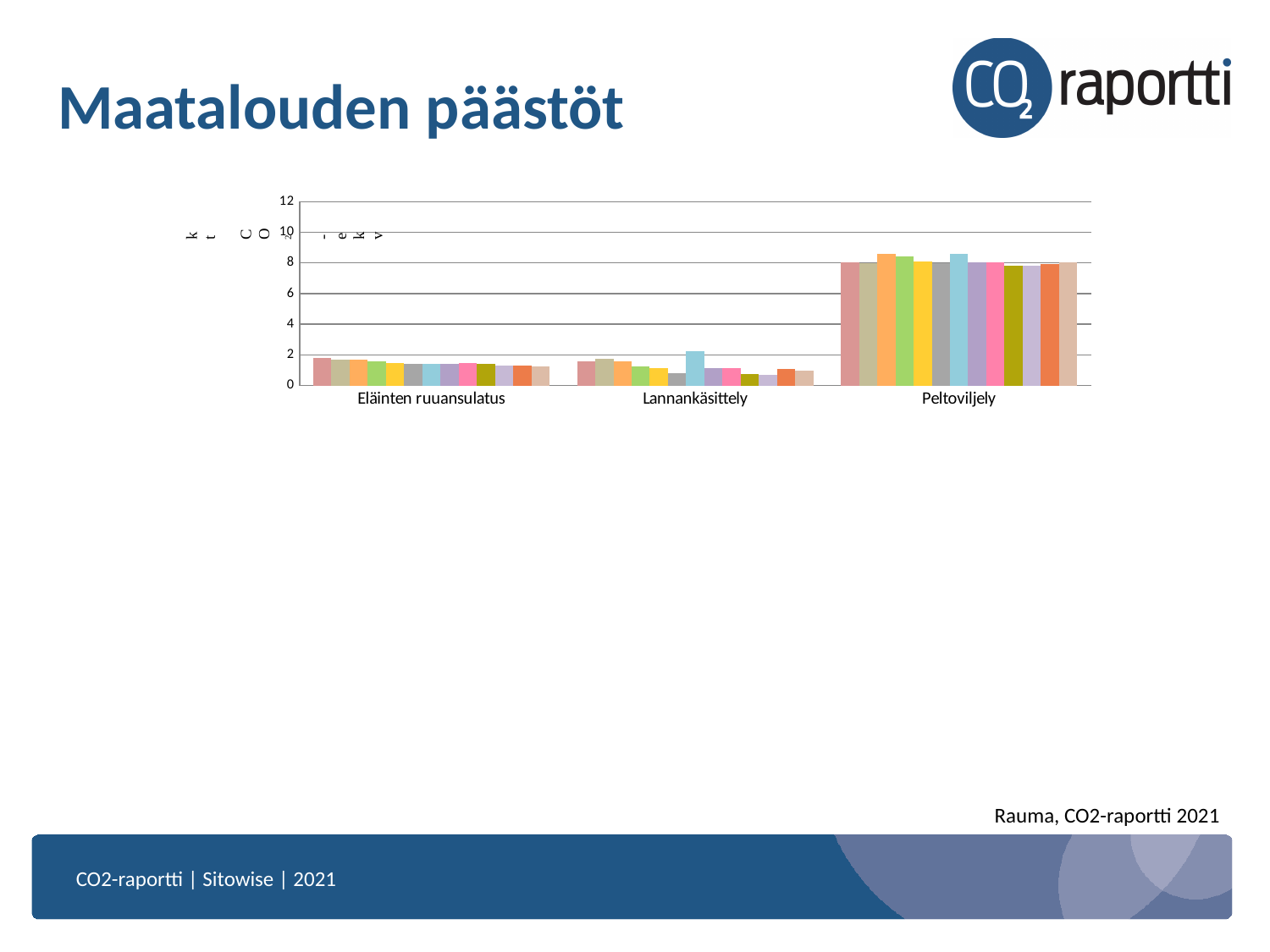
Which category has the highest values in the chart? Peltoviljely What is the maximum value shown on the y axis of the chart? 12 Are the values for Peltoviljely greater or less than 6? greater What is the title of the slide containing the chart? Maatalouden päästöt Are the values for Lannankäsittely greater or less than 4? less What kind of chart is shown on the slide? bar chart Which category has larger values, Peltoviljely or Eläinten ruuansulatus? Peltoviljely How many categories are shown on the x axis of the chart? 3 Are the values for Eläinten ruuansulatus greater or less than 4? less Which category has larger values, Peltoviljely or Lannankäsittely? Peltoviljely